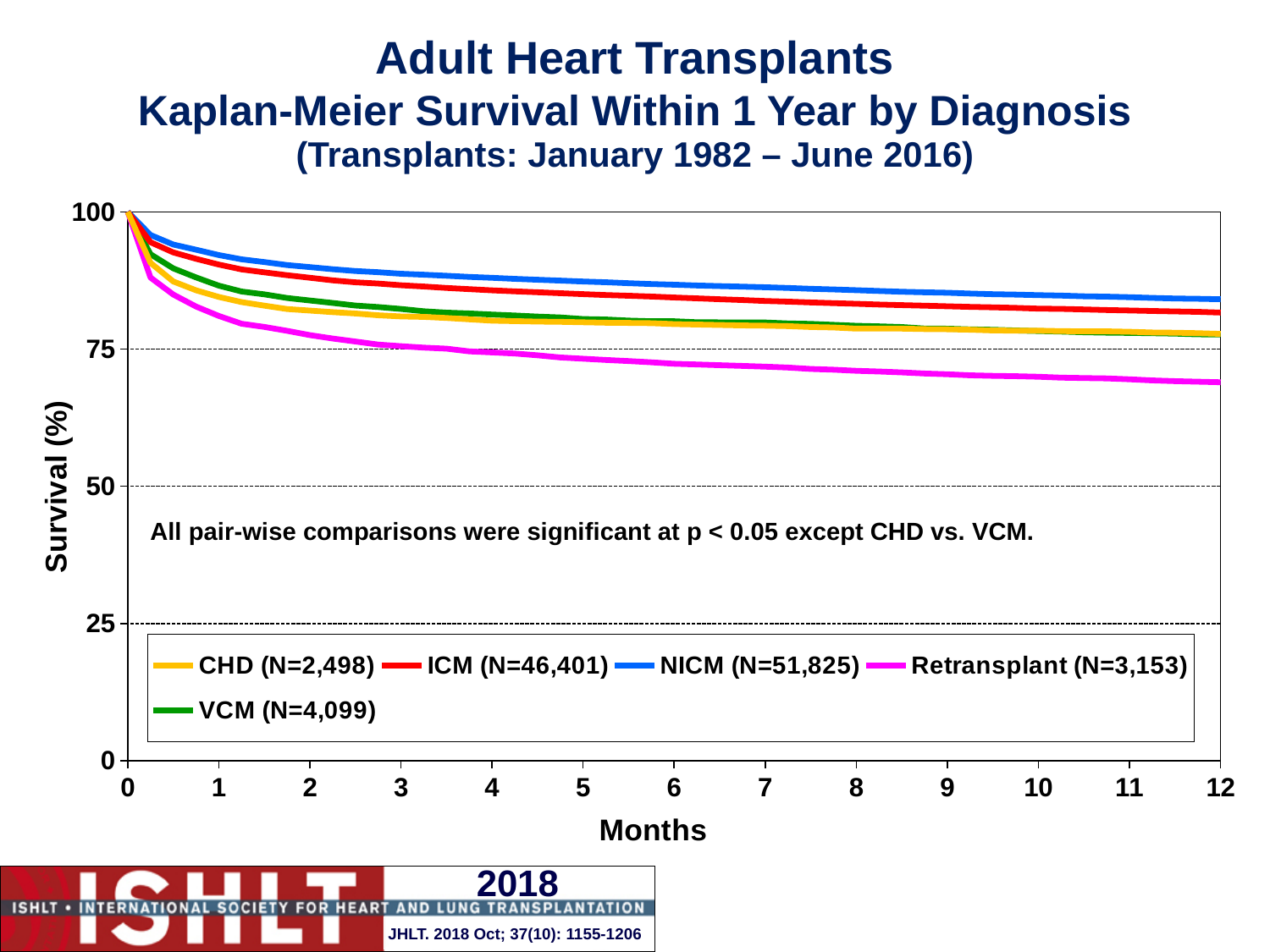
Which diagnosis group has the lowest survival at 12 months? Retransplant At 6 months, which has higher survival: NICM or Retransplant? NICM What is the label of the y axis? Survival (%) What kind of chart is shown on the slide? Line chart Is the survival for ICM at 6 months greater or less than 75? greater Do the survival curves rise or fall as months increase? Fall What is the N for the Retransplant group shown in the legend? 3,153 How many series does the legend list? 5 Which diagnosis group has the highest survival at 12 months? NICM What is the N for the ICM group shown in the legend? 46,401 Is the survival for Retransplant at 12 months greater or less than 75? less Is the survival for NICM at 12 months greater or less than 75? greater